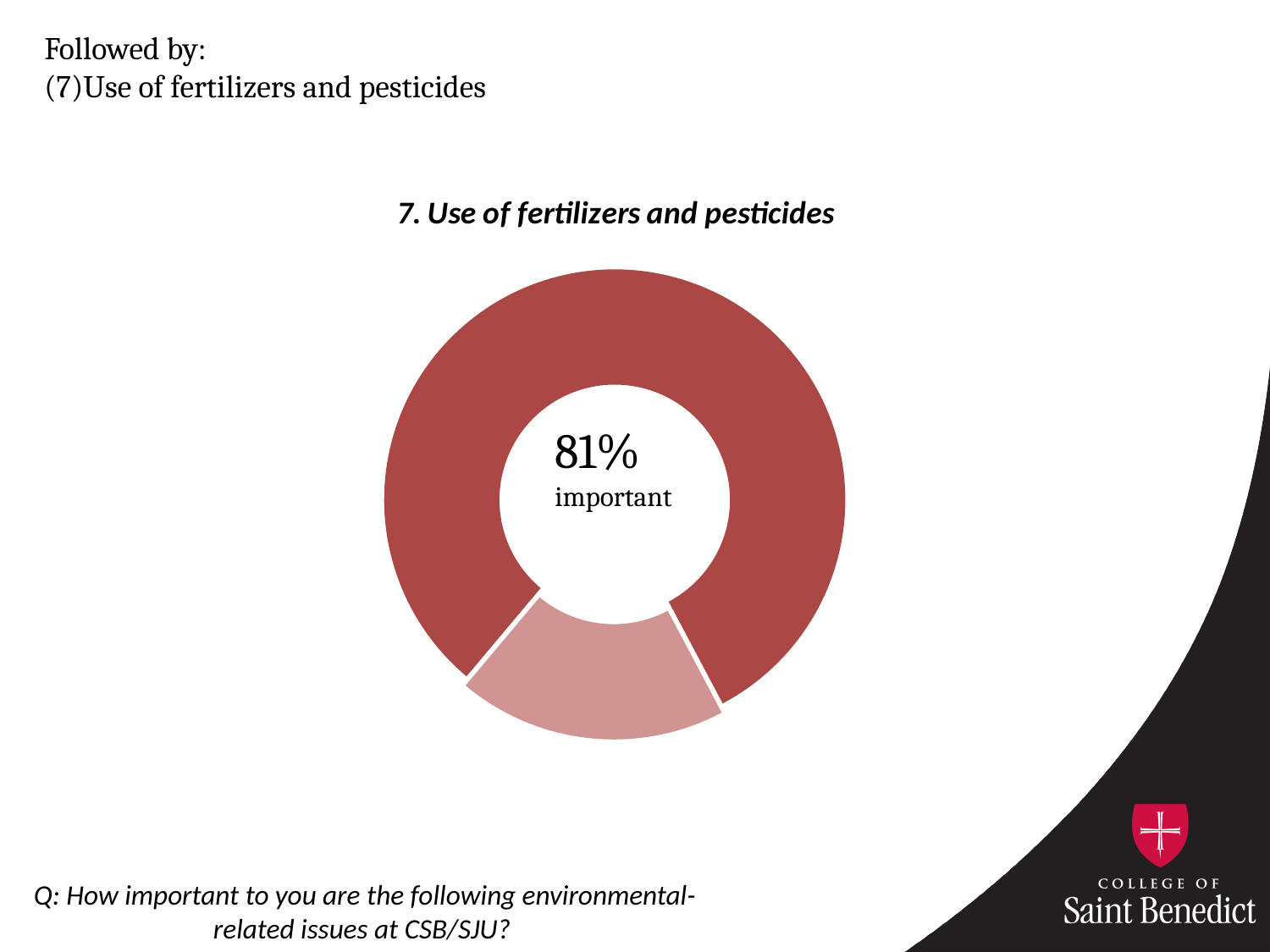
What word appears below the percentage in the centre of the chart? important What percentage of respondents rated the use of fertilizers and pesticides as important? 81% What is the title of the chart? 7. Use of fertilizers and pesticides Which slice of the donut chart is larger, the dark red one or the light pink one? The dark red one How many slices does the donut chart have? 2 What value is printed in the centre of the donut chart? 81% What kind of chart is shown on the slide? Pie chart (donut)